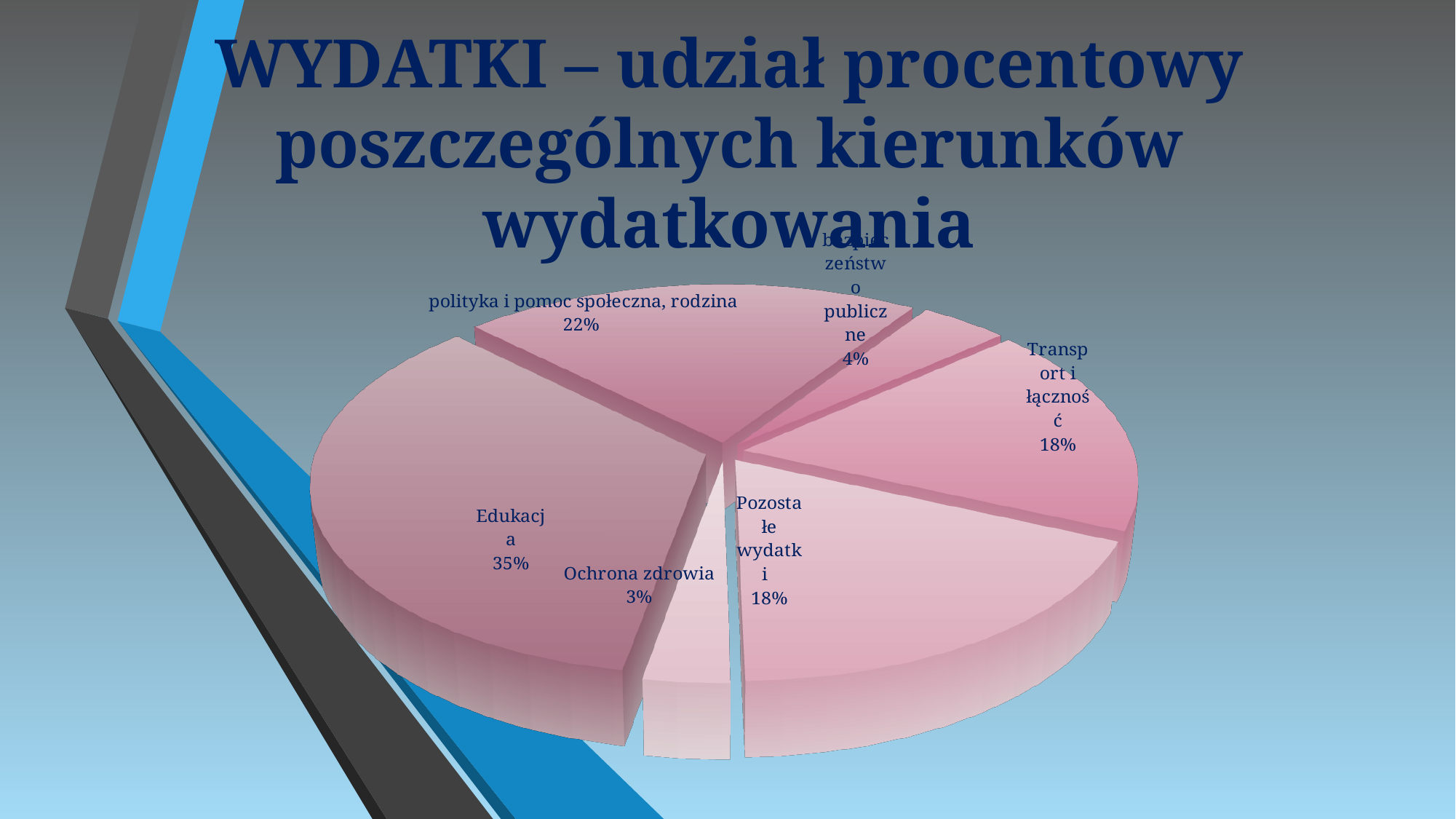
What percentage of expenditure does Edukacja account for? 35% How many categories (slices) does the pie chart show? 6 What percentage is shown for Pozostałe wydatki? 18% Which category has the smallest share of the pie? Ochrona zdrowia What type of chart is shown on the slide? Pie chart What is the share shown for polityka i pomoc społeczna, rodzina? 22% How many percentage points larger is Edukacja than polityka i pomoc społeczna, rodzina? 13 What percentage is shown for Ochrona zdrowia? 3% What percentage is shown for bezpieczeństwo publiczne? 4% What percentage is shown for Transport i łączność? 18% Which category has the largest share of the pie? Edukacja Which is larger: the share for Transport i łączność or the share for Ochrona zdrowia? Transport i łączność